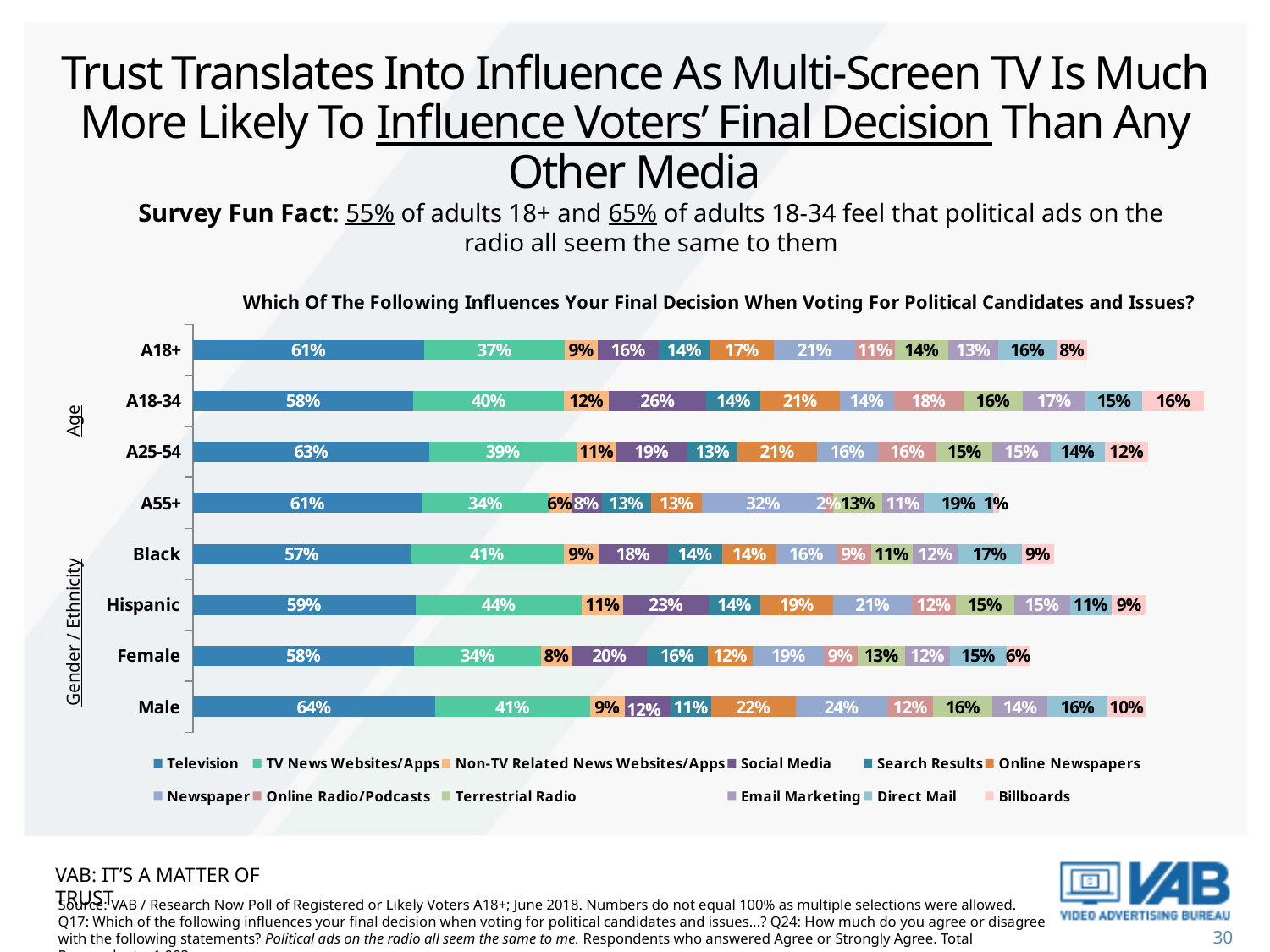
Which group has the lowest Television value? Black What is the difference between the Television value for Male and the Television value for Female? 6% How many series does the legend list? 12 What is the Newspaper value for A55+? 32% Which is larger: the Social Media value for Hispanic or the Social Media value for Black? Hispanic Which series is listed first in the chart legend? Television What percentage of Male respondents say Television influences their final decision? 64% What is the Social Media value for A18-34? 26% Which group has the highest Television value? Male How many groups (categories) are shown on the chart? 8 What is the TV News Websites/Apps value for Hispanic respondents? 44% What kind of chart is shown on the slide? Stacked bar chart